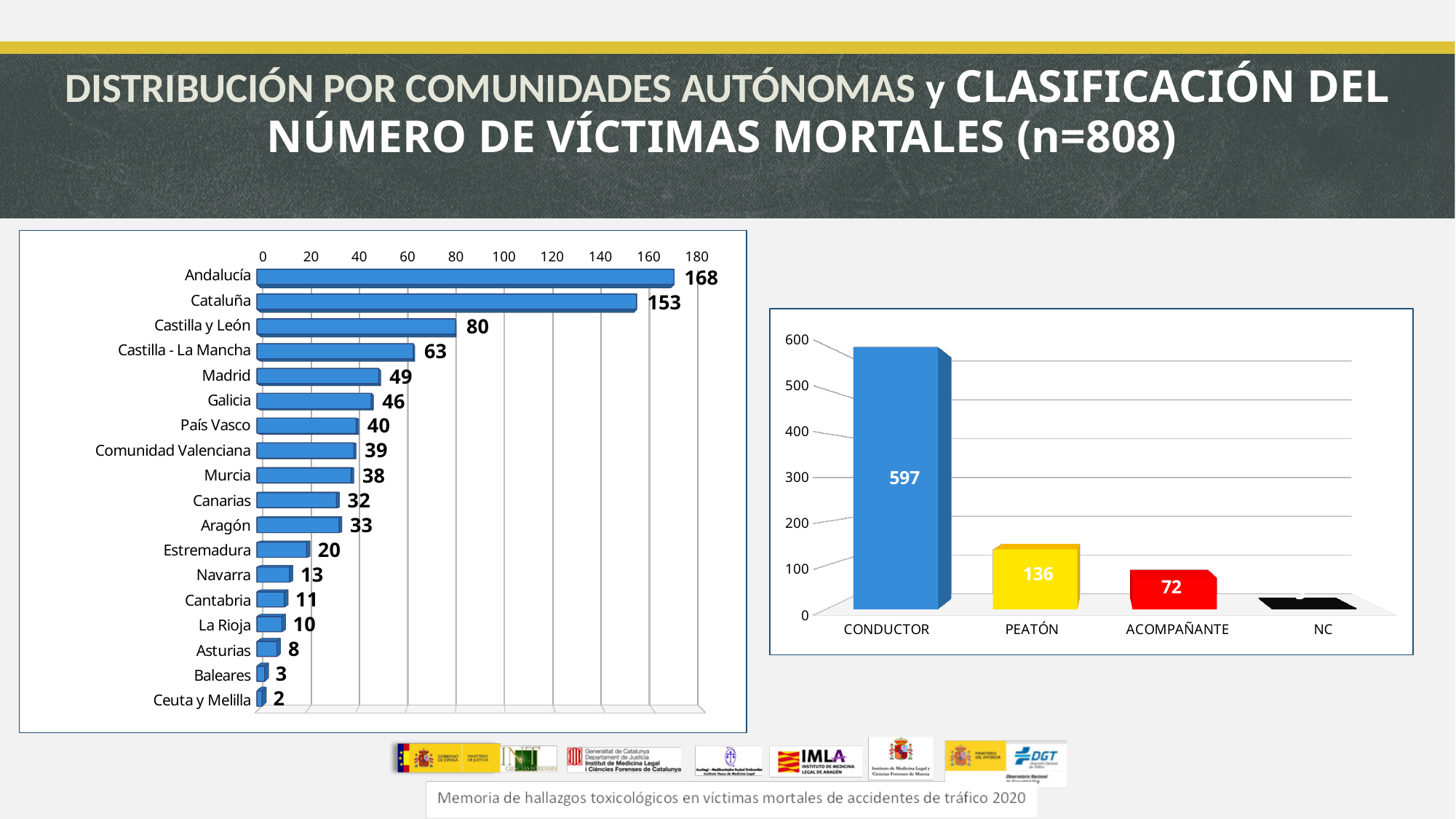
In the left chart (distribution by autonomous community), which community has the highest value? Andalucía In the left chart (distribution by autonomous community), what is the value for Castilla - La Mancha? 63 In the left chart (distribution by autonomous community), which has the larger value, Madrid or Galicia? Madrid In the left chart (distribution by autonomous community), what is the difference between the values for Andalucía and Cataluña? 15 In the left chart (distribution by autonomous community), how many communities are listed? 18 In the right chart (classification of fatal victims), what is the value for PEATÓN? 136 In the right chart (classification of fatal victims), what colour is the PEATÓN bar? Yellow In the left chart (distribution by autonomous community), which community has the lowest value? Ceuta y Melilla What type of chart is the left chart (distribution by autonomous community)? Bar chart In the left chart (distribution by autonomous community), what is the value for Cataluña? 153 In the right chart (classification of fatal victims), is the value for CONDUCTOR greater or less than 500? greater In the right chart (classification of fatal victims), what is the difference between CONDUCTOR and ACOMPAÑANTE? 525